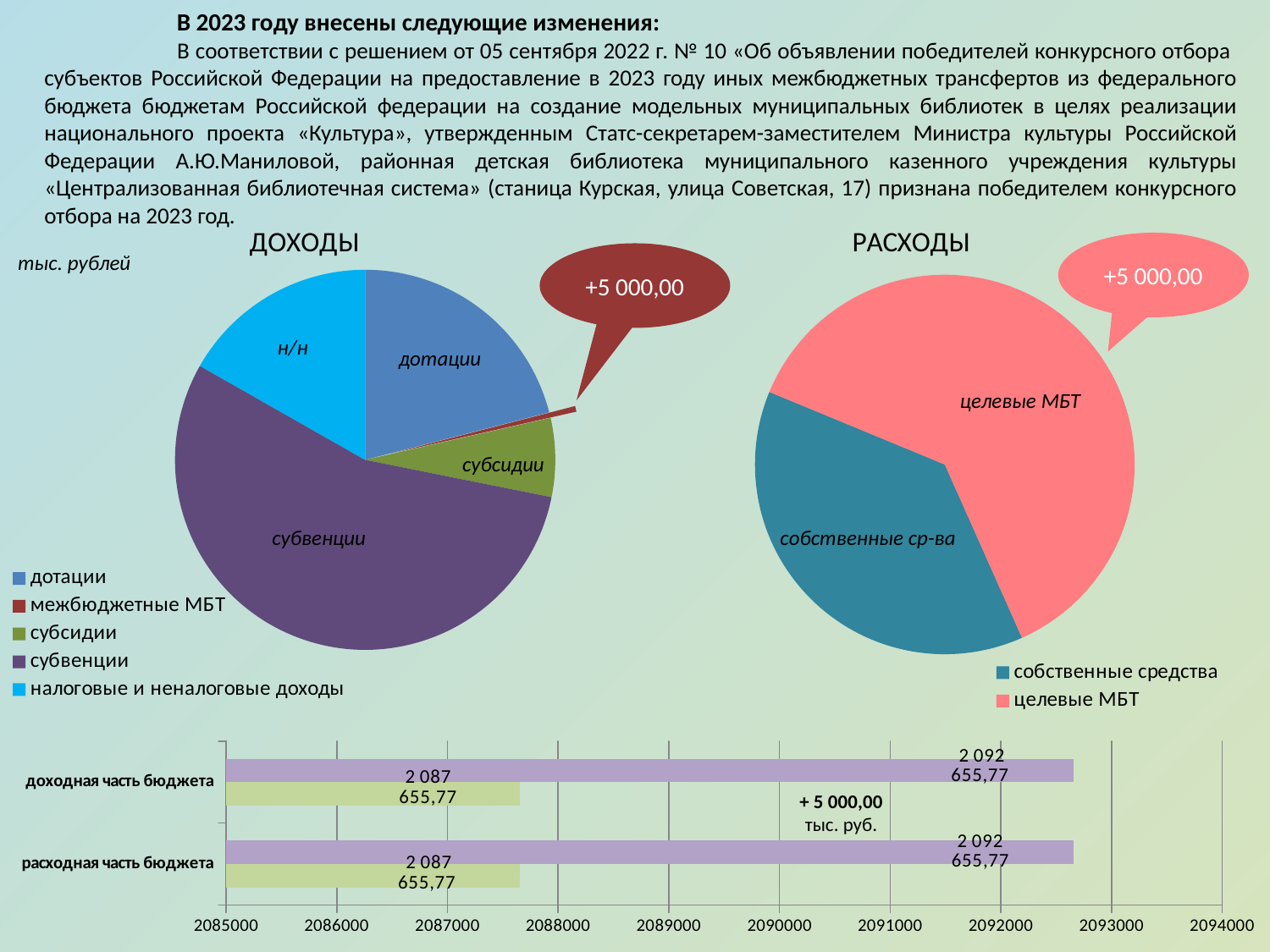
How many entries does the legend of the РАСХОДЫ pie chart list? 2 In the bottom bar chart, how many categories are shown on the vertical axis? 2 In the bottom bar chart, is the green bar for доходная часть бюджета greater or less than 2088000? less What kind of chart is the chart titled ДОХОДЫ? pie chart In the ДОХОДЫ pie chart, which slice is larger: дотации or субсидии? дотации In the bottom bar chart, what is the value of the green bar for расходная часть бюджета? 2 087 655,77 What kind of chart is the chart at the bottom of the slide? bar chart In the bottom bar chart, what is the value of the purple bar for доходная часть бюджета? 2 092 655,77 How many entries does the legend of the ДОХОДЫ pie chart list? 5 In the ДОХОДЫ pie chart, which category has the smallest slice? межбюджетные МБТ In the ДОХОДЫ pie chart, which category has the largest slice? субвенции In the РАСХОДЫ pie chart, which slice is larger: целевые МБТ or собственные средства? целевые МБТ